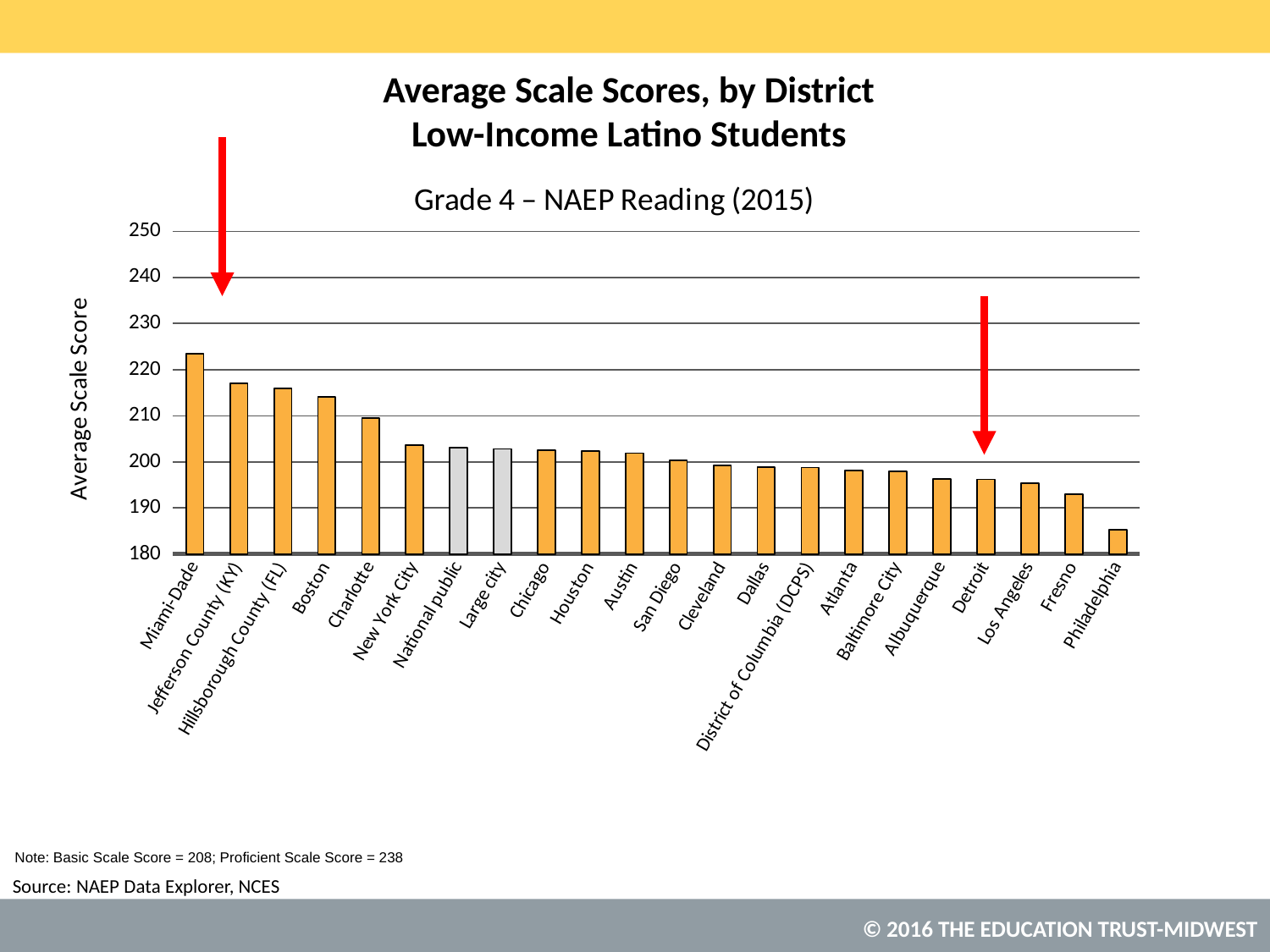
Is the value for Miami-Dade greater or less than 220? greater Is the value for Boston greater or less than 210? greater Which district has the highest average scale score? Miami-Dade What kind of chart is shown on the slide? bar chart What is the title of the y axis? Average Scale Score Is the value for Philadelphia greater or less than 190? less Do the values rise or fall moving from left to right along the x axis? fall How many categories are plotted along the x axis? 22 Which district has the lowest average scale score? Philadelphia Which is larger, the value for Boston or the value for Detroit? Boston